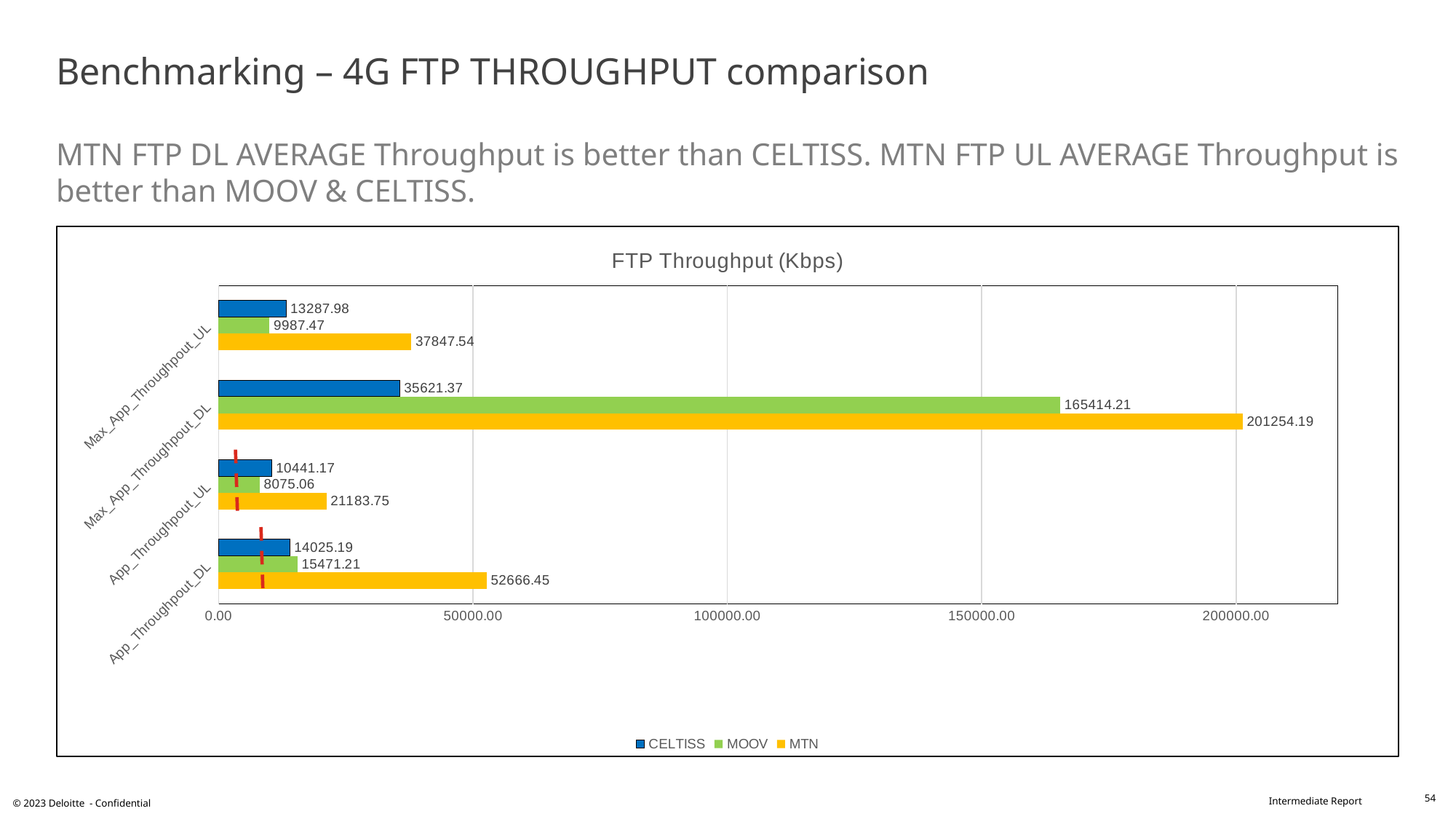
What type of chart is shown? Bar chart Which operator has the highest value for Max_App_Throughpout_UL? MTN What is the CELTISS value for App_Throughpout_UL? 10441.17 What is the difference between the MTN and MOOV values for Max_App_Throughpout_DL? 35839.98 Which operator has the lowest value for App_Throughpout_UL? MOOV Is the MOOV value for Max_App_Throughpout_DL greater or less than 150000.00? greater What is the MTN value for Max_App_Throughpout_DL? 201254.19 What is the difference between the MTN and CELTISS values for App_Throughpout_DL? 38641.26 How many categories are shown on the vertical axis? 4 How many series does the legend list? 3 For App_Throughpout_DL, which is larger: the CELTISS value or the MOOV value? MOOV What is the MOOV value for App_Throughpout_DL? 15471.21